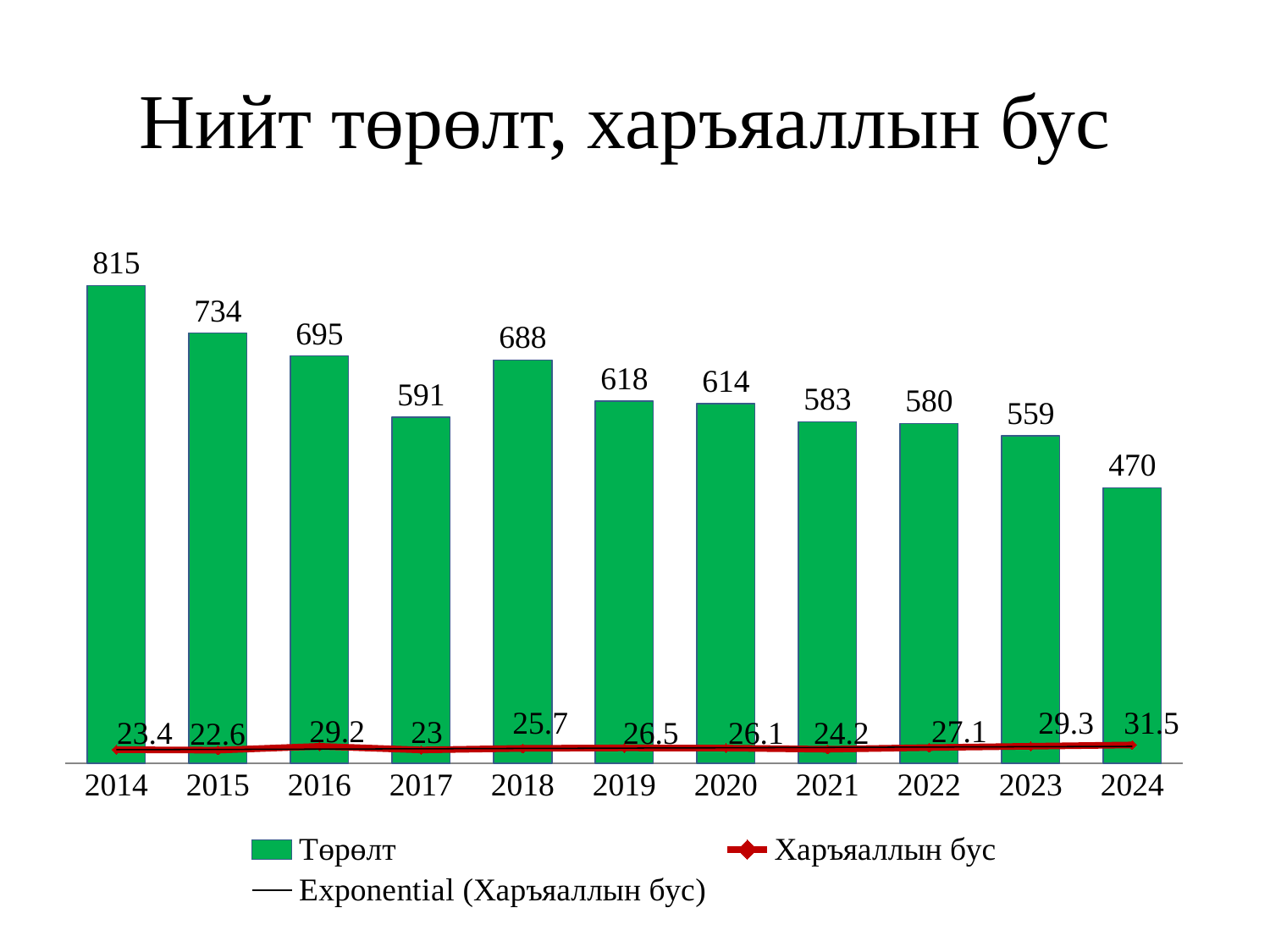
How many entries does the legend list? 3 What is the Төрөлт value for 2014? 815 How many years are shown on the x axis? 11 Which year has the lowest Харъяаллын бус value? 2015 Which is larger, the Төрөлт value for 2017 or for 2018? 2018 What is the title of the chart? Нийт төрөлт, харъяаллын бус What is the Төрөлт value for 2018? 688 Which year has the lowest Төрөлт value? 2024 Which year has the highest Төрөлт value? 2014 What is the Харъяаллын бус value for 2024? 31.5 What is the difference between the Төрөлт values for 2014 and 2024? 345 Do the Төрөлт values generally rise or fall from 2014 to 2024? fall